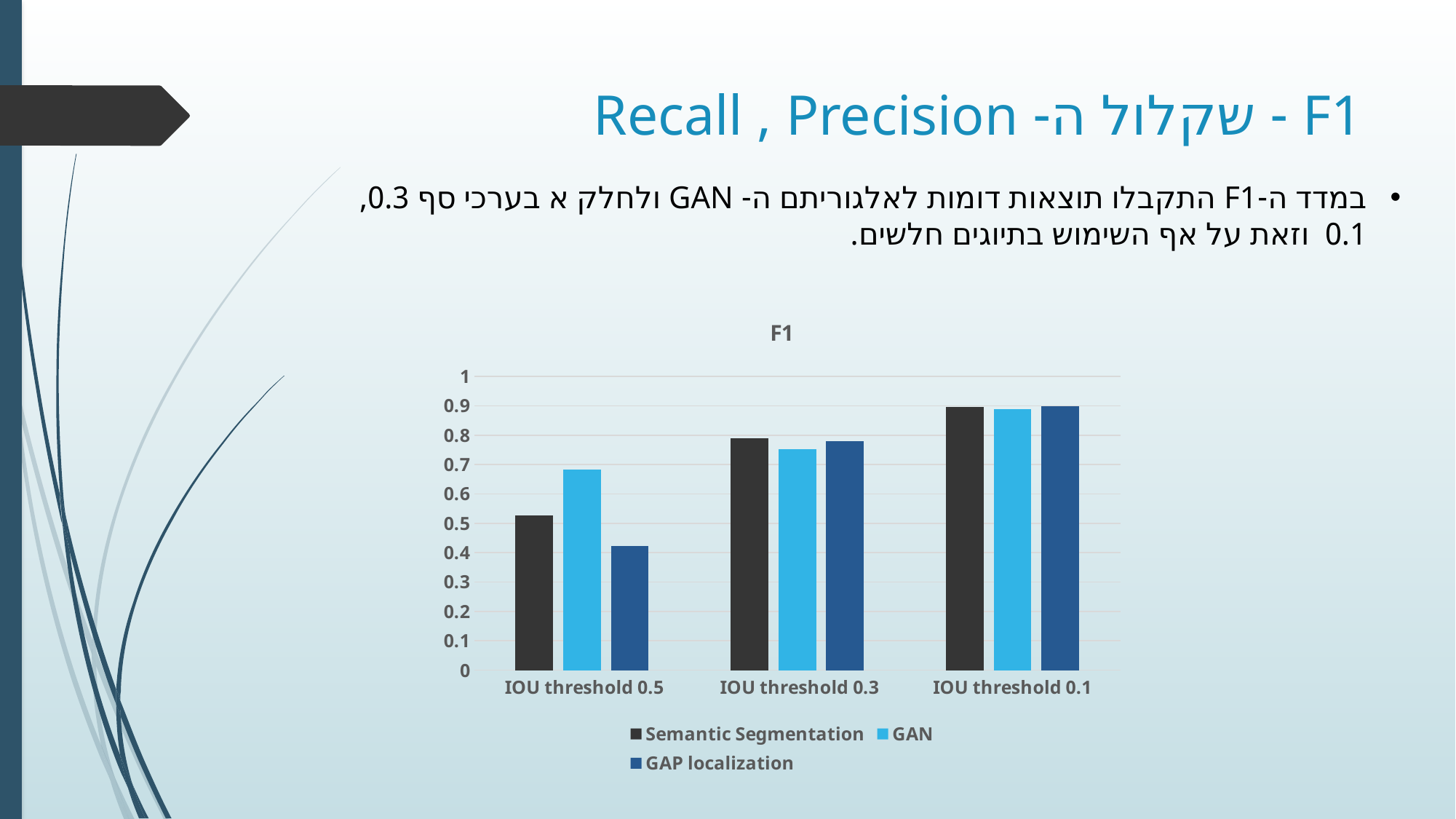
What kind of chart is shown on the slide? bar chart Is the value for GAP localization at IOU threshold 0.5 greater or less than 0.5? less Which series has the lowest value at IOU threshold 0.5? GAP localization How many categories are shown on the x axis? 3 Which series is shown in light blue in the legend? GAN Is the value for Semantic Segmentation at IOU threshold 0.1 greater or less than 0.8? greater Do the values for GAP localization rise or fall from IOU threshold 0.5 to IOU threshold 0.1? rise What is the title of the chart? F1 Which is larger at IOU threshold 0.5: Semantic Segmentation or GAN? GAN Which series has the highest value at IOU threshold 0.5? GAN Is the value for GAN at IOU threshold 0.5 greater or less than 0.6? greater How many series does the legend list? 3